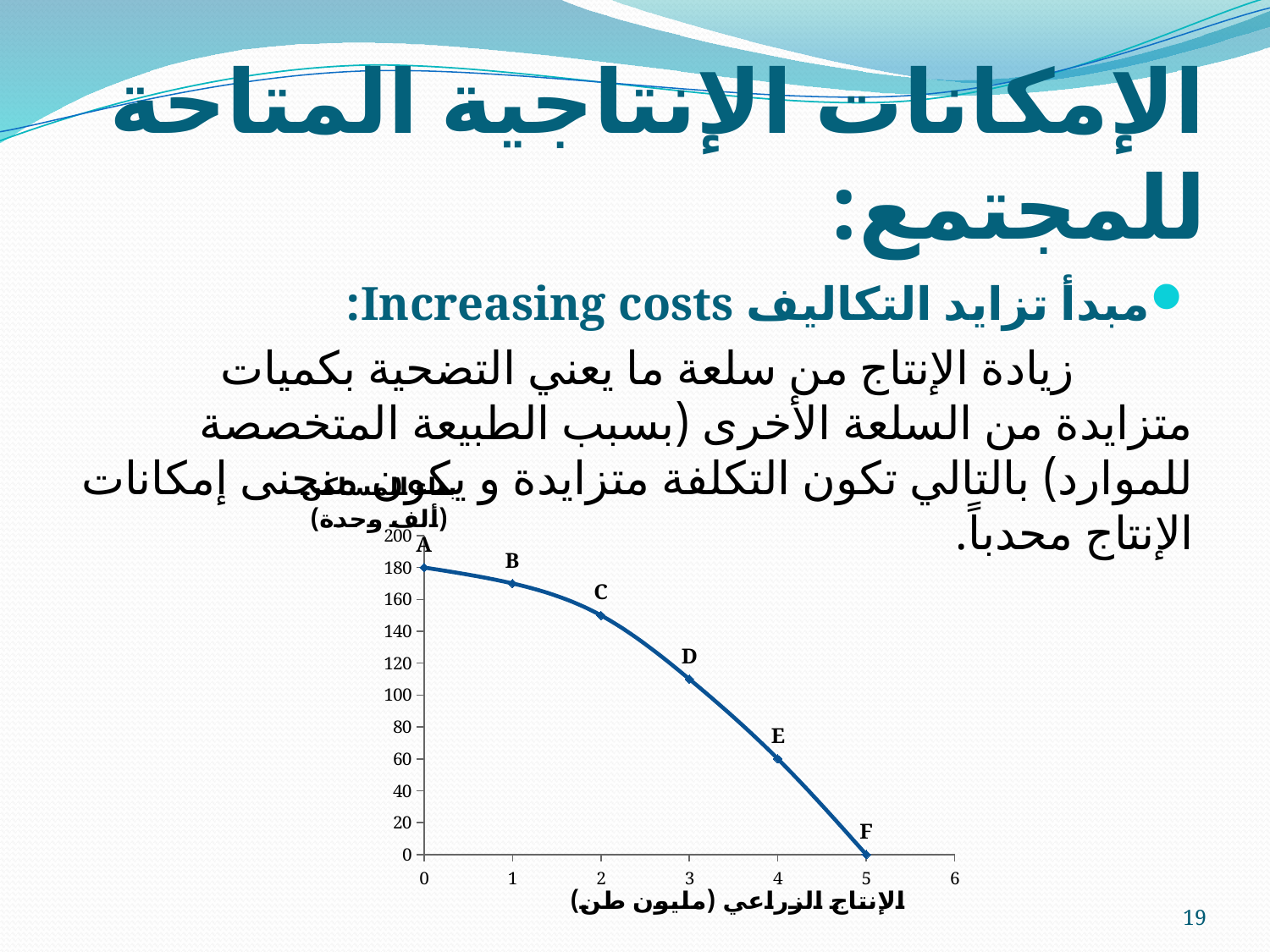
At what value on the horizontal axis is point D located? 3 Is the vertical-axis value at point C greater or less than 140? greater Which labelled point has the highest value on the vertical axis? A Which point has a larger vertical-axis value, B or D? B Is the vertical-axis value at point D greater or less than 120? less Do the values rise or fall as you move from left to right along the horizontal axis? fall Which labelled point has the lowest value on the vertical axis? F What is the value on the vertical axis at point E? 60 What kind of chart is shown on the slide? line chart What is the value on the vertical axis at point F? 0 What is the value on the vertical axis at point A? 180 How many labelled points are plotted on the curve? 6